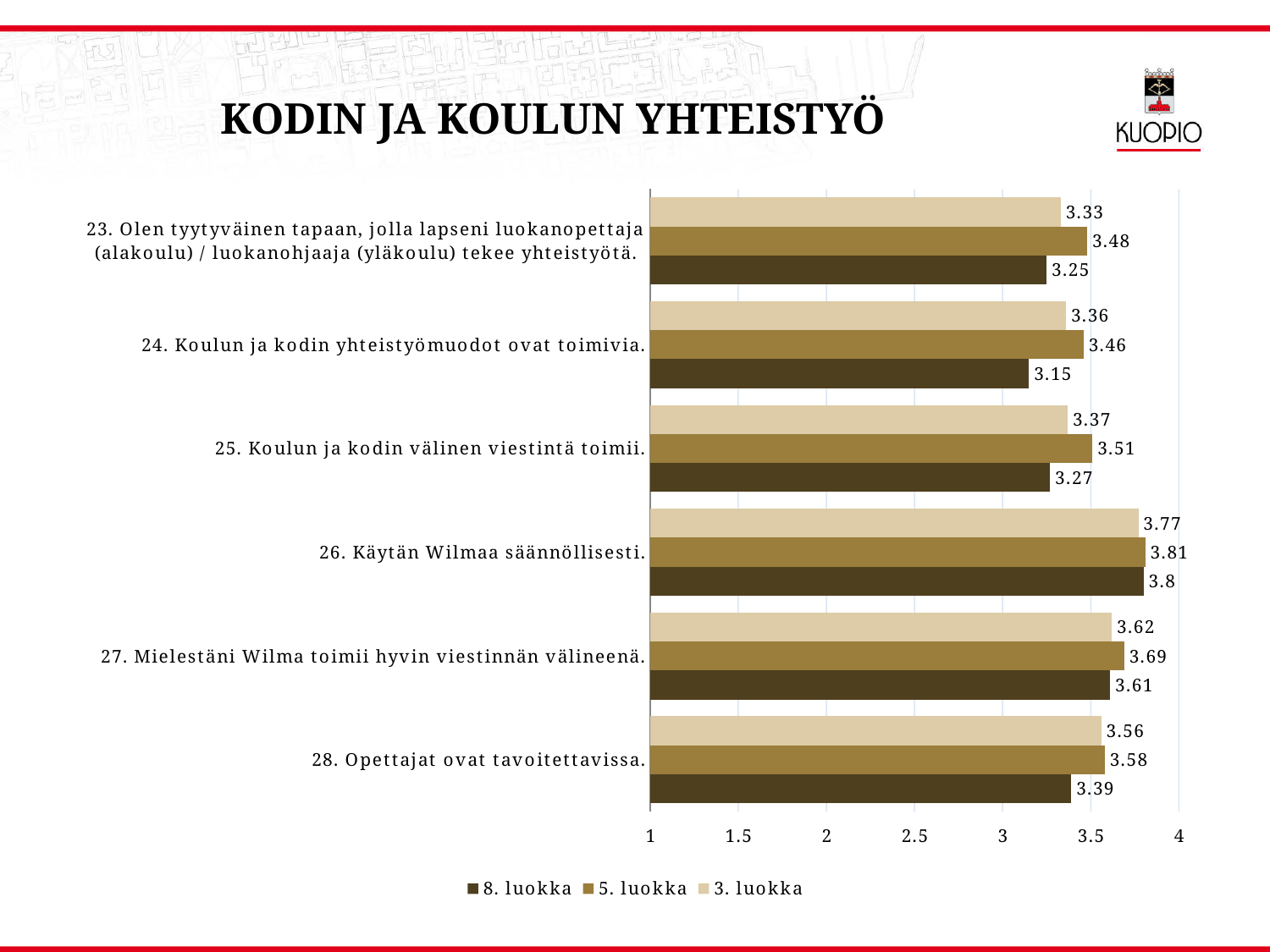
What is the value for 5. luokka on statement 25 (Koulun ja kodin välinen viestintä toimii)? 3.51 How many statements (categories) are plotted on the chart? 6 How many series does the legend list? 3 What is the value for 8. luokka on statement 24 (Koulun ja kodin yhteistyömuodot ovat toimivia)? 3.15 Which series is shown with the darkest bars? 8. luokka Is the value for 8. luokka on statement 26 greater or less than 3.5? greater What is the difference between the 5. luokka and 8. luokka values on statement 24? 0.31 What kind of chart is shown on the slide? bar chart Which statement has the highest value for 5. luokka? 26. Käytän Wilmaa säännöllisesti. On statement 23, which is larger: the value for 5. luokka or the value for 8. luokka? 5. luokka What is the value for 3. luokka on statement 28 (Opettajat ovat tavoitettavissa)? 3.56 Which statement has the lowest value for 8. luokka? 24. Koulun ja kodin yhteistyömuodot ovat toimivia.